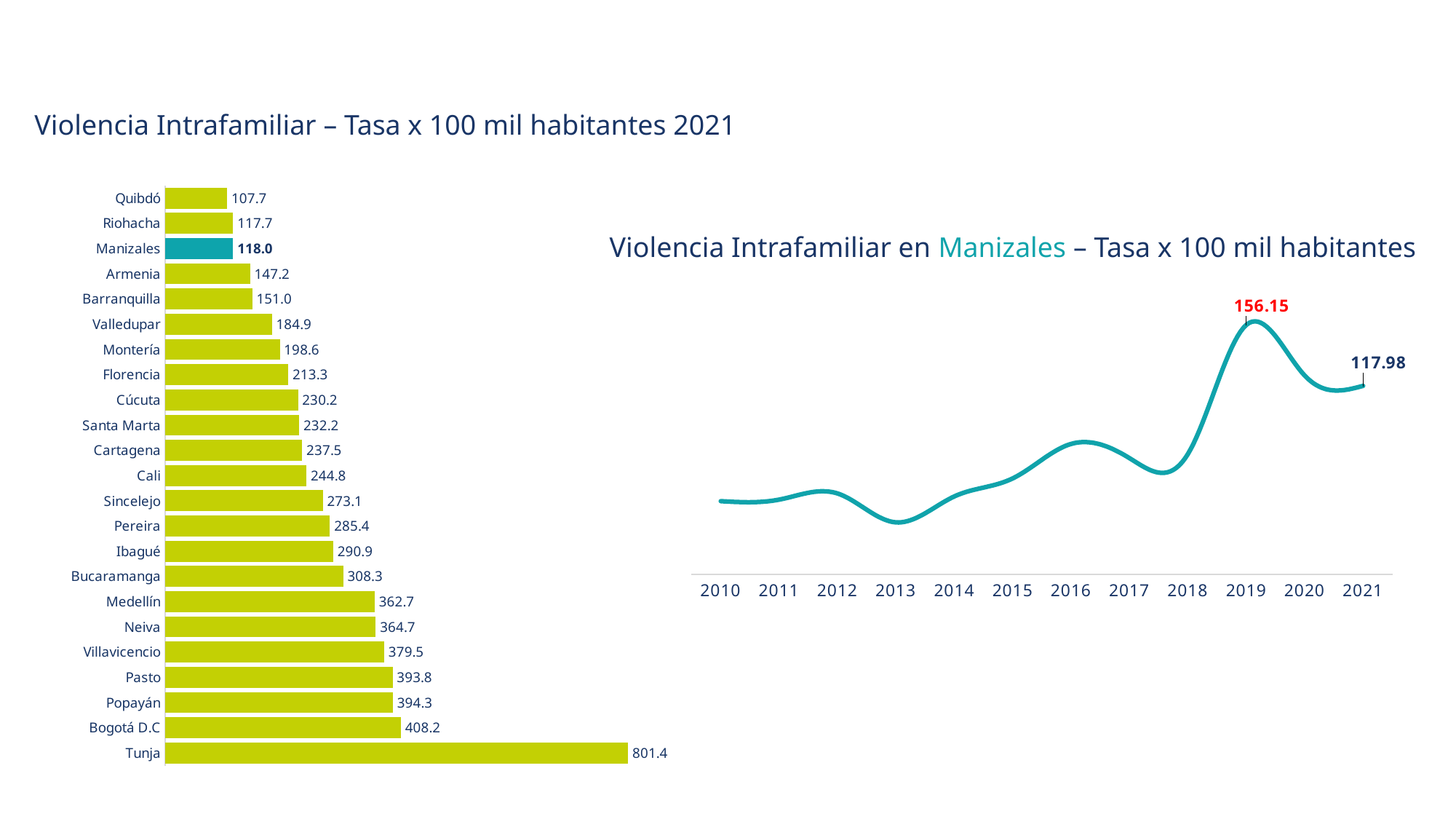
In the bar chart on the left, what is the value for Bogotá D.C? 408.2 In the bar chart on the left, which city has the highest rate? Tunja What kind of chart is the chart on the left? Bar chart In the line chart on the right, what is the value for 2019? 156.15 In the bar chart on the left, what is the value for Manizales? 118.0 In the bar chart on the left, what is the difference between the values for Tunja and Bogotá D.C? 393.2 In the bar chart on the left, which is larger, the value for Medellín or the value for Cali? Medellín How many cities are shown in the bar chart on the left? 23 In the line chart on the right, what is the difference between the values for 2019 and 2021? 38.17 In the bar chart on the left, which bar is shown in a different colour from the others? Manizales In the bar chart on the left, which city has the lowest rate? Quibdó How many years are shown on the x axis of the line chart on the right? 12